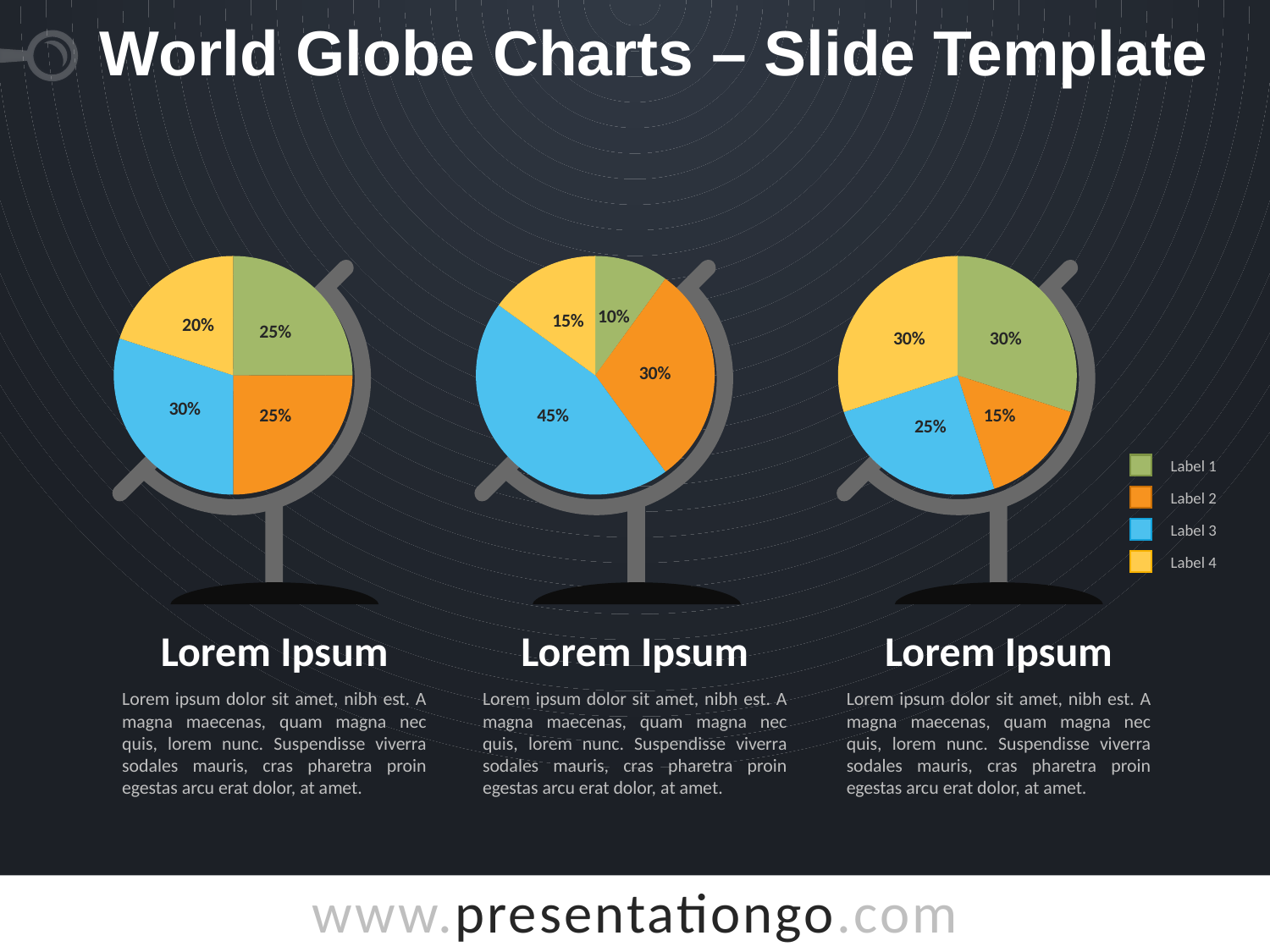
In the right pie chart, what is the value for Label 2? 15% In the left pie chart, which label has the smallest share? Label 4 In the middle pie chart, which is larger, Label 4 or Label 1? Label 4 In the middle pie chart, what is the value for Label 3? 45% In the right pie chart, which label has the smallest share? Label 2 In the middle pie chart, which label has the largest share? Label 3 In the left pie chart, what is the value for Label 3? 30% In the left pie chart, what is the value for Label 4? 20% How many slices does the right pie chart have? 4 In the middle pie chart, what is the difference between Label 2 and Label 1? 20% How many entries does the legend list? 4 What kind of chart is shown on the left globe? Pie chart